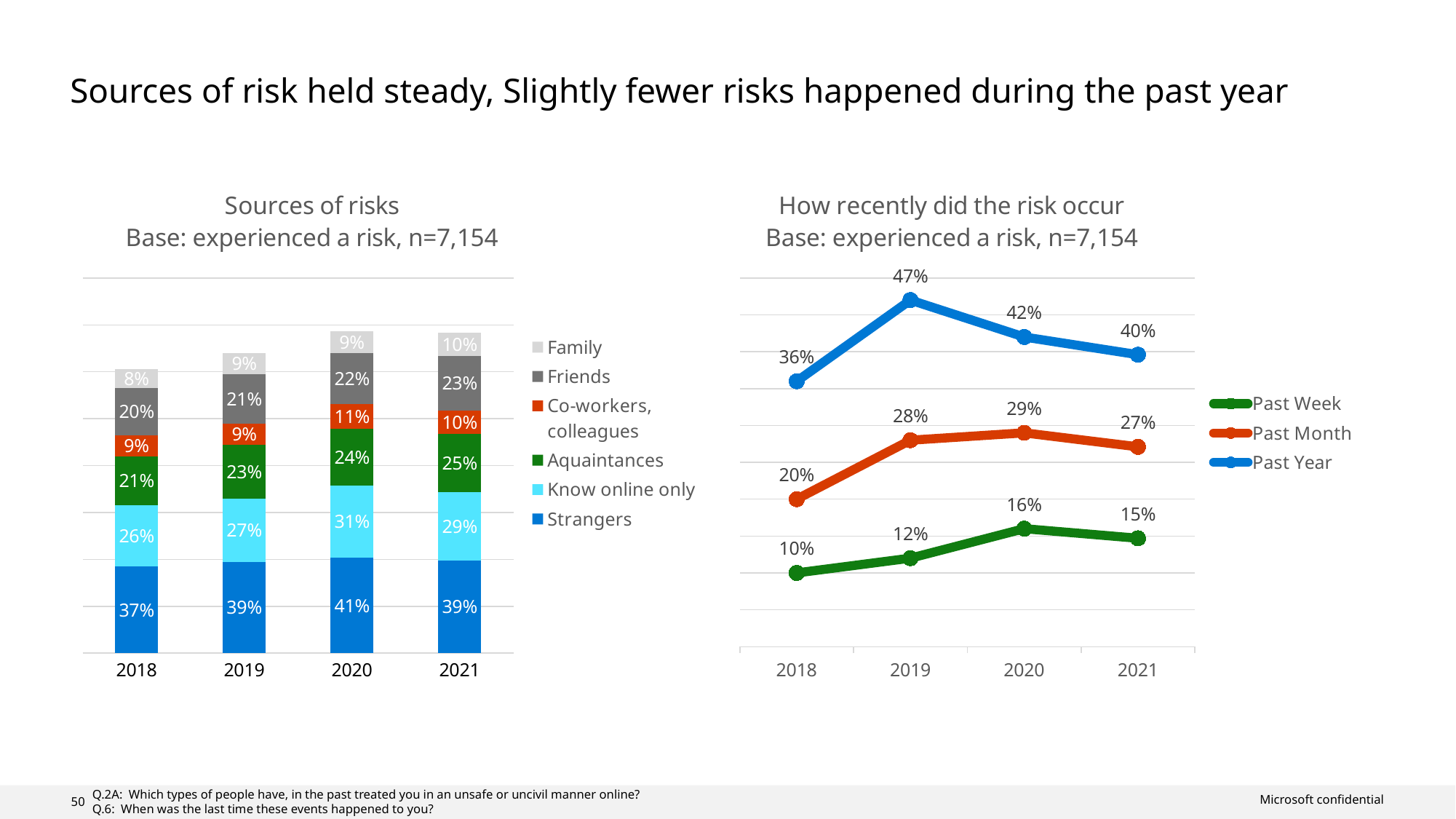
In the 'How recently did the risk occur' chart, does the Past Year line rise or fall from 2019 to 2021? Fall In the 'How recently did the risk occur' chart, what is the Past Year value for 2019? 47% What kind of chart is the 'Sources of risks' chart? Stacked bar chart In the 'Sources of risks' chart, what is the difference between the Acquaintances values for 2021 and 2018? 4% In the 'Sources of risks' chart, how many series does the legend list? 6 In the 'How recently did the risk occur' chart, which year has the lowest Past Week value? 2018 In the 'How recently did the risk occur' chart, which is larger in 2021: Past Month or Past Week? Past Month In the 'How recently did the risk occur' chart, what is the difference between the Past Month values for 2020 and 2018? 9% In the 'Sources of risks' chart, what is the value for Strangers in 2020? 41% In the 'How recently did the risk occur' chart, how many years are shown on the x axis? 4 In the 'Sources of risks' chart, which year has the highest value for Strangers? 2020 In the 'Sources of risks' chart, what is the value for Know online only in 2021? 29%